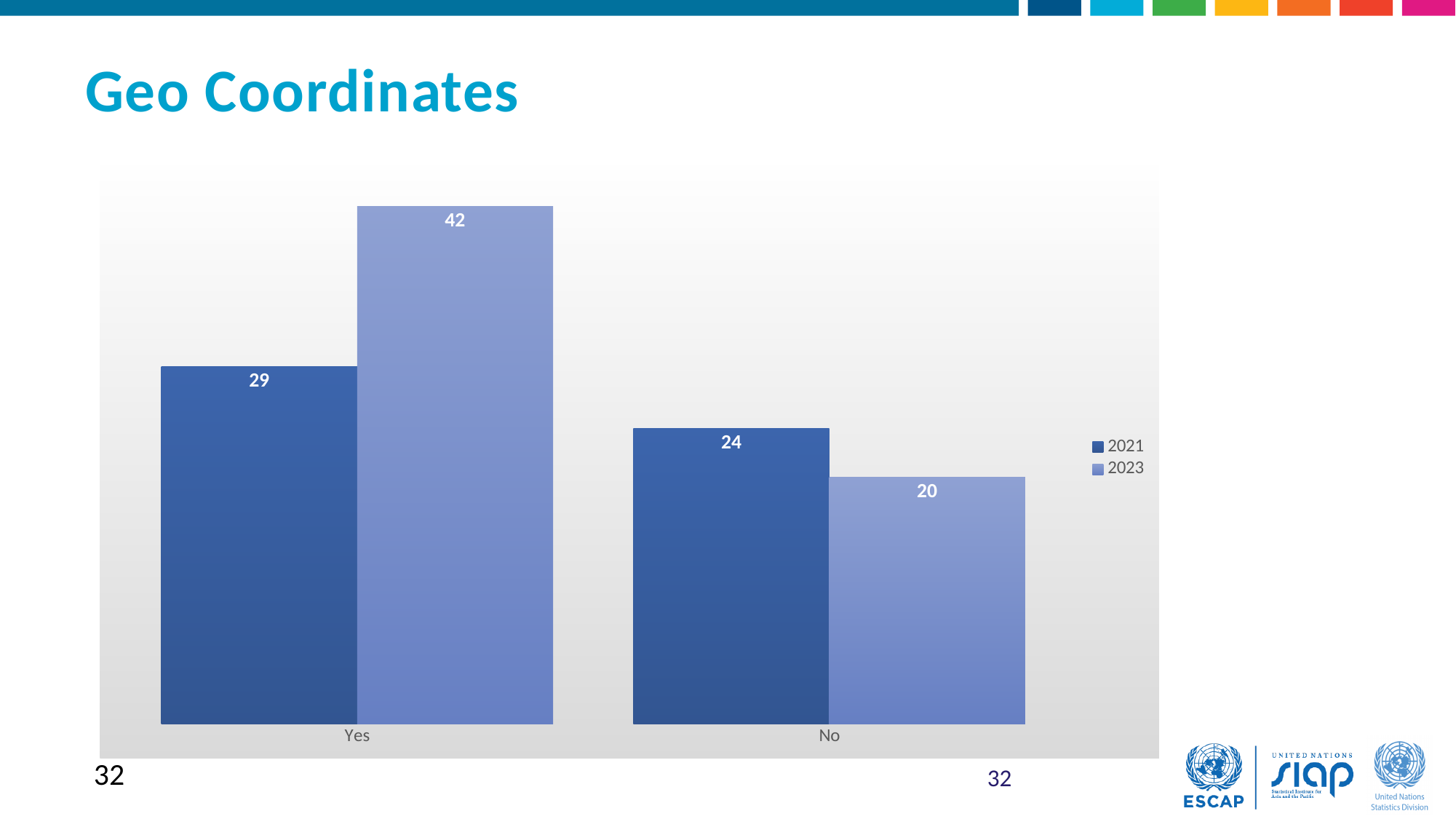
Which category has the highest value in the 2023 series? Yes How many series does the legend list? 2 How many categories are shown on the x axis? 2 Which is larger for No: the 2021 value or the 2023 value? 2021 What is the difference between the 2021 and 2023 values for No? 4 What is the value for Yes in the 2021 series? 29 What is the value for No in the 2021 series? 24 What kind of chart is shown on the slide? Bar chart What is the value for Yes in the 2023 series? 42 What is the difference between the 2023 and 2021 values for Yes? 13 Which category has the lowest value in the 2021 series? No What is the value for No in the 2023 series? 20